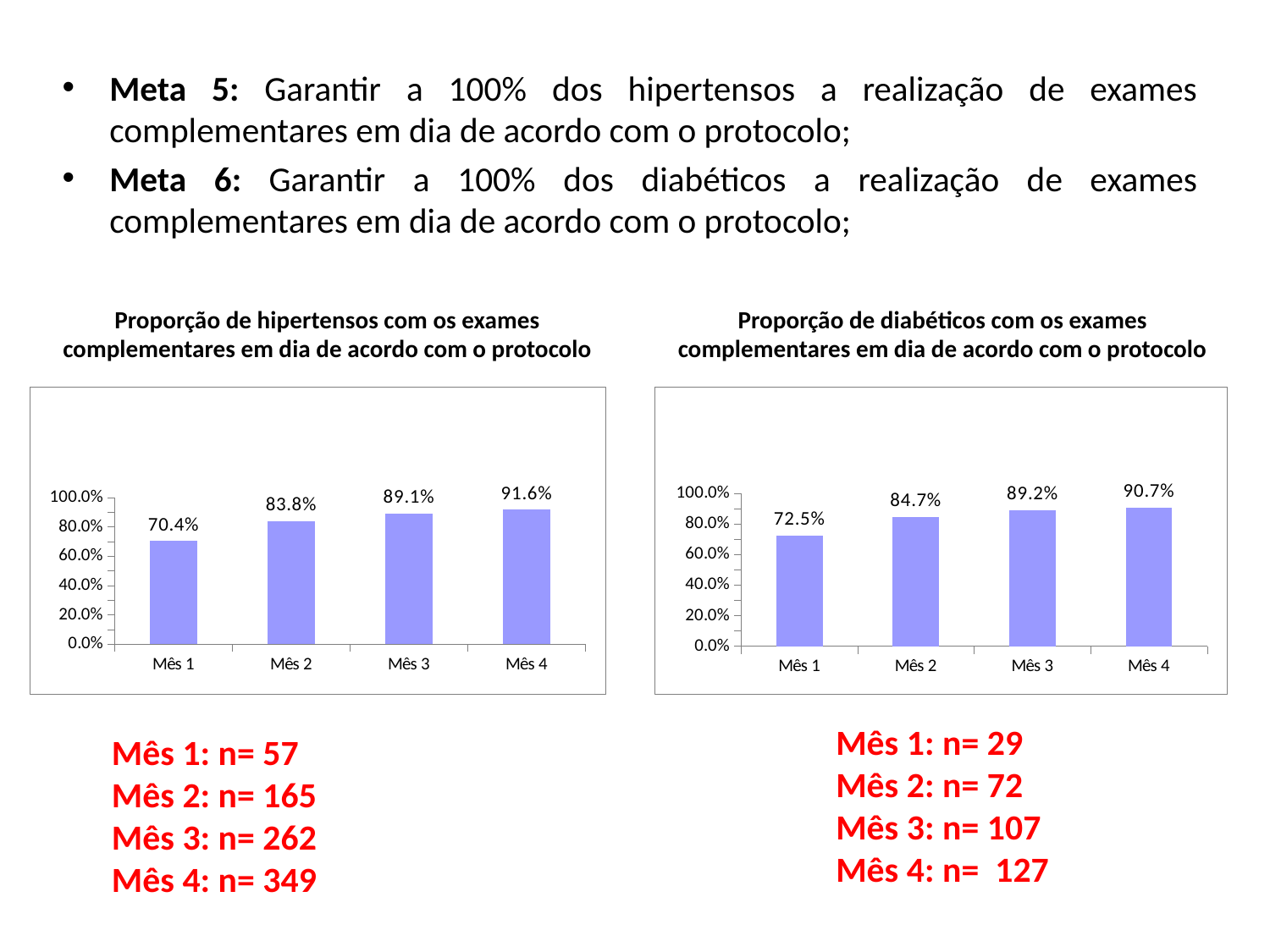
In the left chart (Proporção de hipertensos), what is the difference between the values for Mês 4 and Mês 1? 21.2% In the right chart (Proporção de diabéticos), which month has the lowest value? Mês 1 In the left chart (Proporção de hipertensos), which is larger, the value for Mês 2 or the value for Mês 3? Mês 3 In the left chart (Proporção de hipertensos), which month has the highest value? Mês 4 What kind of chart is the left chart (Proporção de hipertensos)? Bar chart In the left chart (Proporção de hipertensos com os exames complementares em dia de acordo com o protocolo), what is the value for Mês 1? 70.4% In the right chart (Proporção de diabéticos com os exames complementares em dia de acordo com o protocolo), what is the value for Mês 2? 84.7% In the left chart (Proporção de hipertensos), what is the value for Mês 3? 89.1% In the right chart (Proporção de diabéticos), what is the difference between the values for Mês 3 and Mês 2? 4.5% In the right chart (Proporção de diabéticos), what is the value for Mês 4? 90.7% In the right chart (Proporção de diabéticos), do the values rise or fall from Mês 1 to Mês 4? Rise In the right chart (Proporção de diabéticos), how many months are plotted? 4